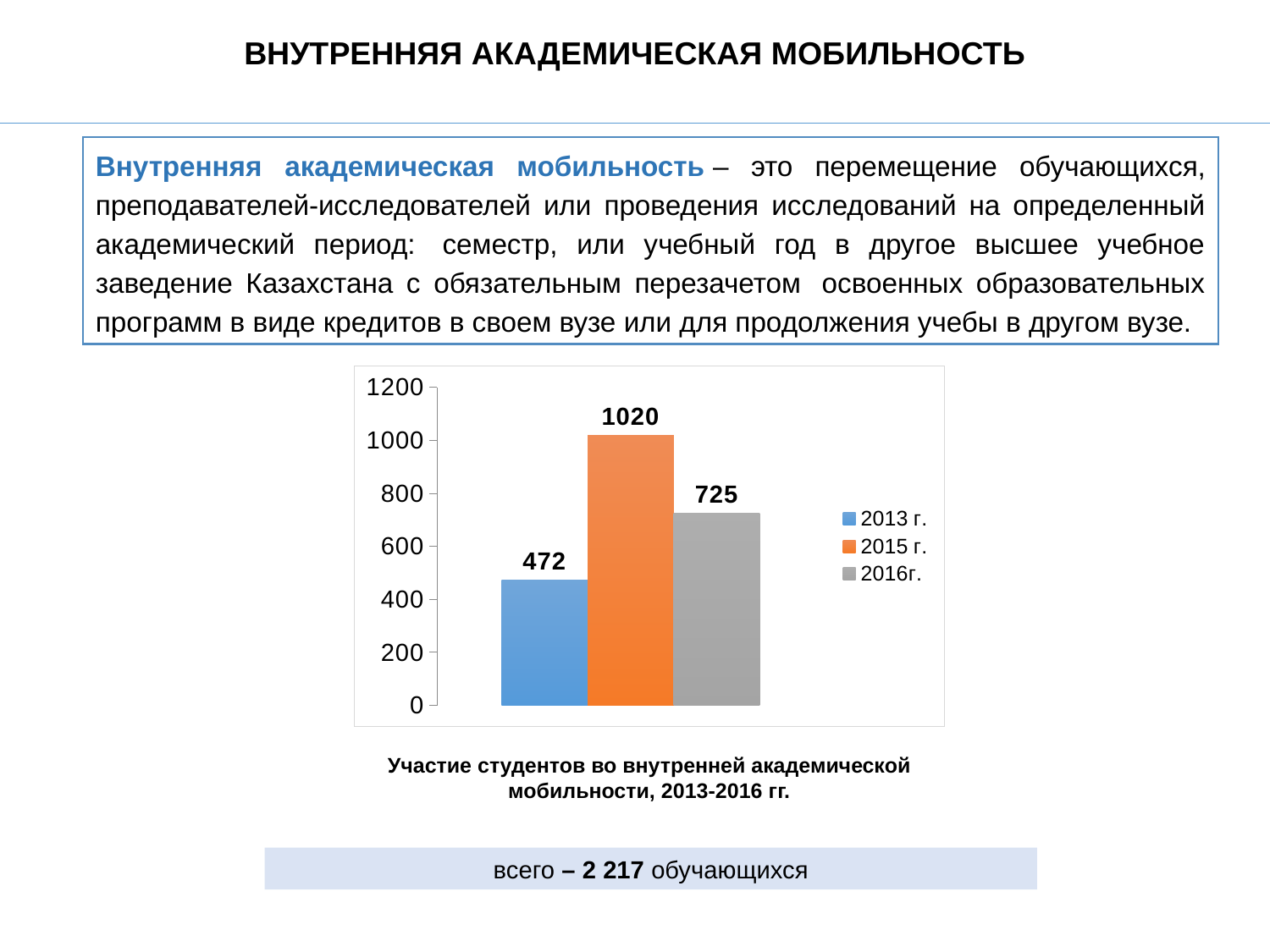
What kind of chart is shown on the slide? bar chart What is the value for 2015 г.? 1020 What is the value for 2013 г.? 472 How many series does the legend list? 3 Which year has the lowest value? 2013 г. Which year has the highest value? 2015 г. What is the value for 2016г.? 725 What is the difference between the values for 2015 г. and 2016г.? 295 What is the difference between the values for 2015 г. and 2013 г.? 548 Which is larger, the value for 2016г. or the value for 2013 г.? 2016г. Is the value for 2015 г. greater or less than 1000? greater What colour is the bar for 2015 г.? orange